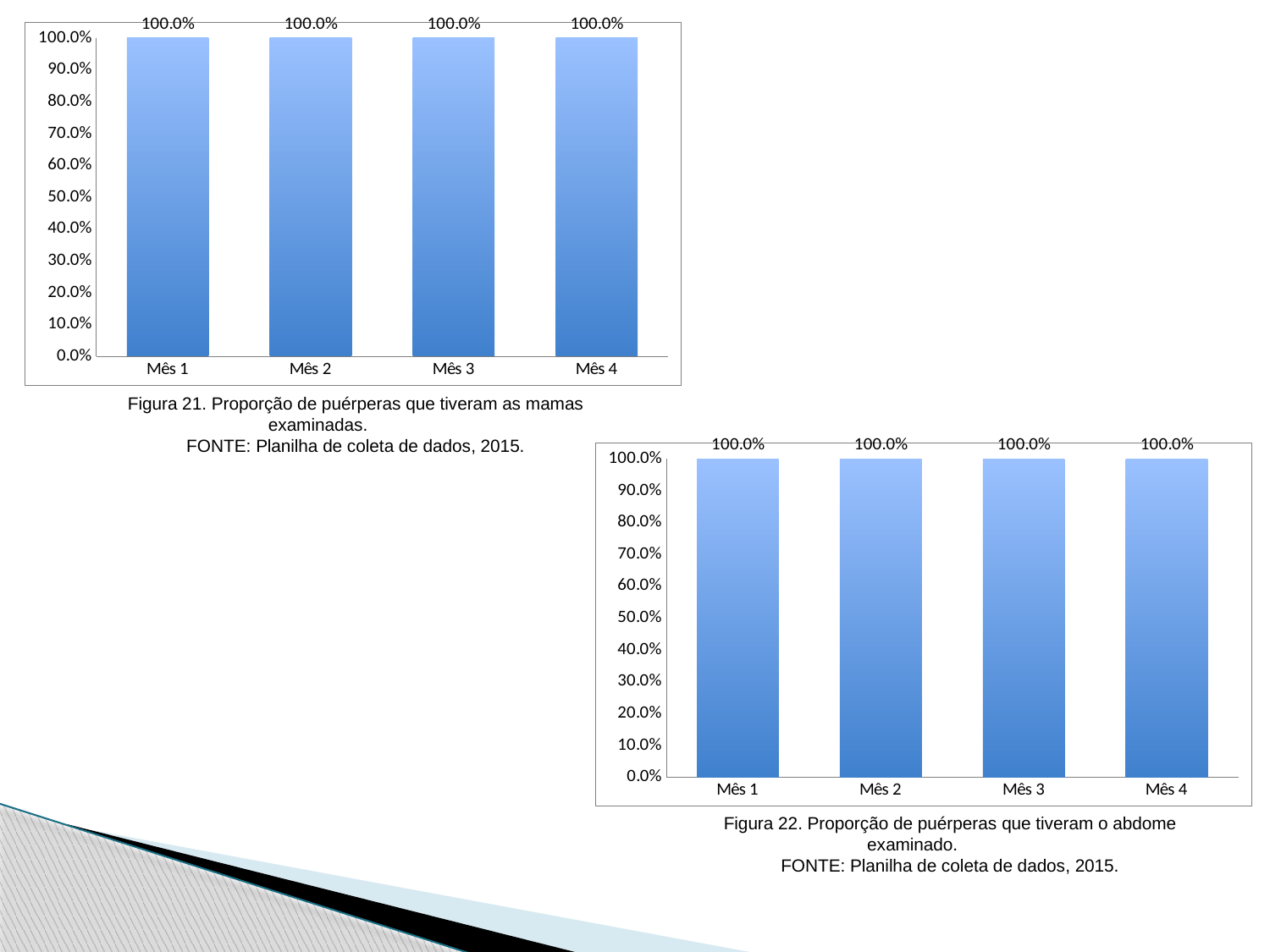
In the top-left chart (Figura 21), is the value for Mês 2 greater or less than 50.0%? greater What is the caption of the bottom-right chart? Figura 22. Proporção de puérperas que tiveram o abdome examinado. In the bottom-right chart (Figura 22), how many bars are plotted? 4 In the bottom-right chart (Figura 22), what is the value for Mês 2? 100.0% In the top-left chart (Figura 21), what is the difference between the values for Mês 1 and Mês 3? 0.0% In the bottom-right chart (Figura 22), do the values rise, fall, or stay the same from Mês 1 to Mês 4? Stay the same What kind of chart is the top-left chart (Figura 21)? Bar chart In the top-left chart (Figura 21), how many categories are shown on the x axis? 4 In the top-left chart (Figura 21), what is the value for Mês 1? 100.0% What kind of chart is the bottom-right chart (Figura 22)? Bar chart In the bottom-right chart (Figura 22), what is the value for Mês 3? 100.0% In the top-left chart (Figura 21), what is the value for Mês 4? 100.0%